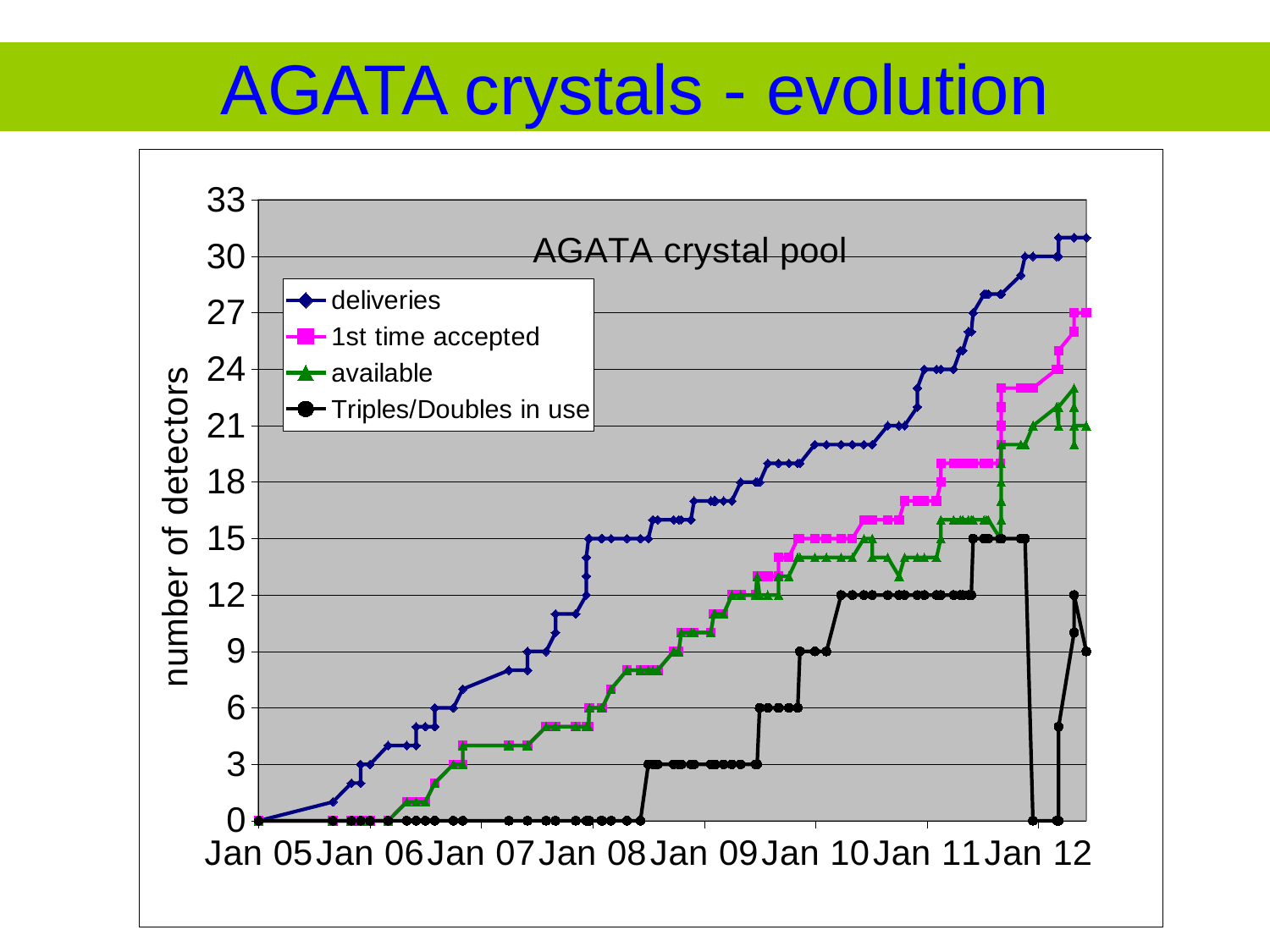
What kind of chart is shown on the slide? line chart Is the value of the Triples/Doubles in use series at Jan 11 greater or less than 9? greater What is the label of the vertical axis? number of detectors At Jan 12, which series has the larger value: deliveries or available? deliveries Do the values of the deliveries series rise or fall from Jan 05 to Jan 12? rise What is the value of the deliveries series at Jan 05? 0 Is the value of the available series at Jan 12 greater or less than 18? greater Which series reaches the highest value on the chart? deliveries How many series does the legend list? 4 What is the value of the Triples/Doubles in use series at Jan 07? 0 What is the title printed inside the chart area? AGATA crystal pool